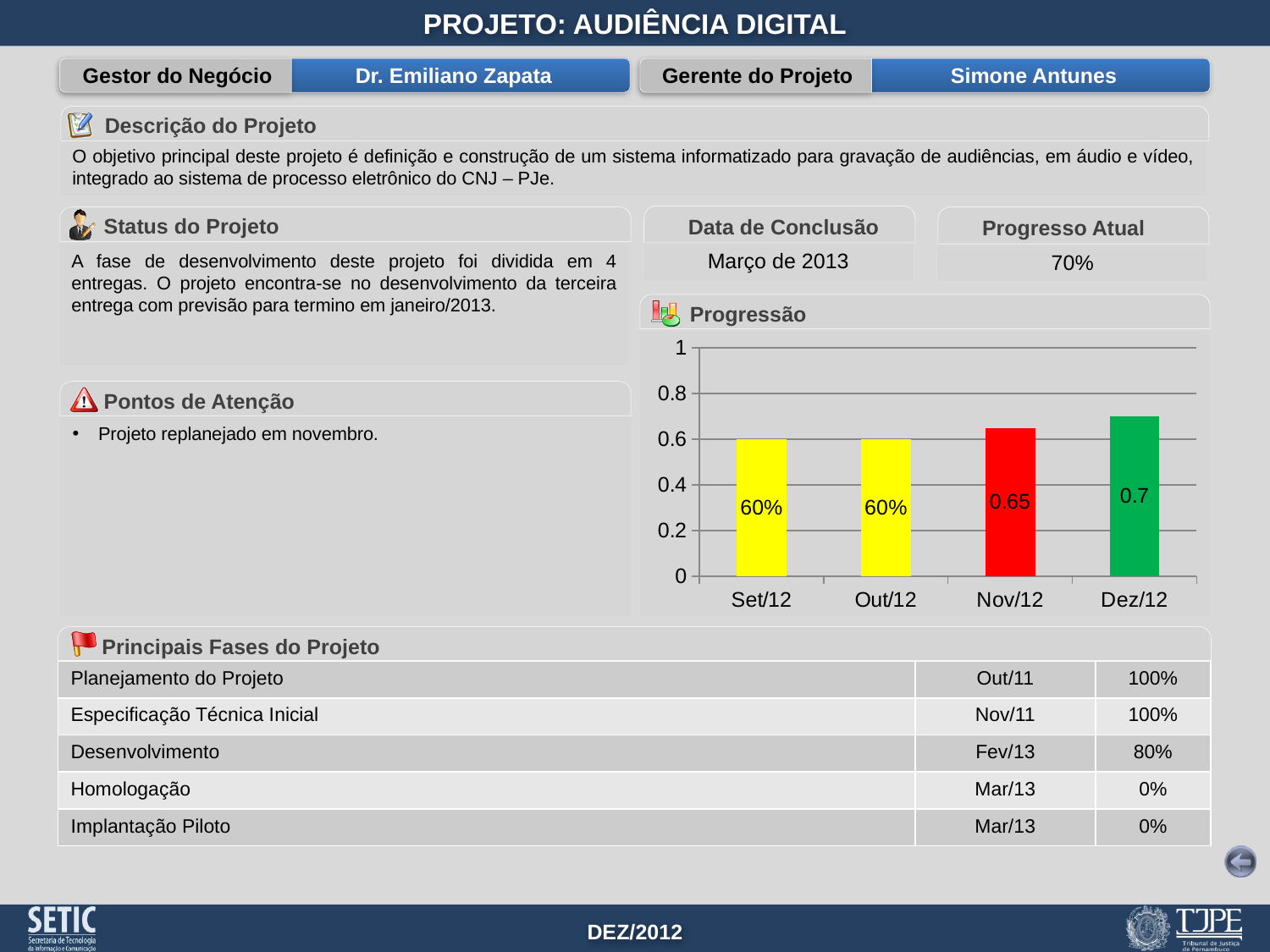
Do the values in the Progressão chart rise or fall from Set/12 to Dez/12? rise In the Progressão chart, which is larger: the value for Nov/12 or the value for Out/12? Nov/12 How many months are shown on the x axis of the Progressão chart? 4 What is the value shown for Set/12 in the Progressão chart? 60% Which month has the highest bar in the Progressão chart? Dez/12 What kind of chart is the Progressão chart? bar chart What colour is the Dez/12 bar in the Progressão chart? green What is the value shown for Dez/12 in the Progressão chart? 0.7 What is the value shown for Out/12 in the Progressão chart? 60% Is the value for Set/12 in the Progressão chart greater or less than 0.8? less What is the difference between the Dez/12 and Nov/12 values in the Progressão chart? 0.05 What is the value shown for Nov/12 in the Progressão chart? 0.65